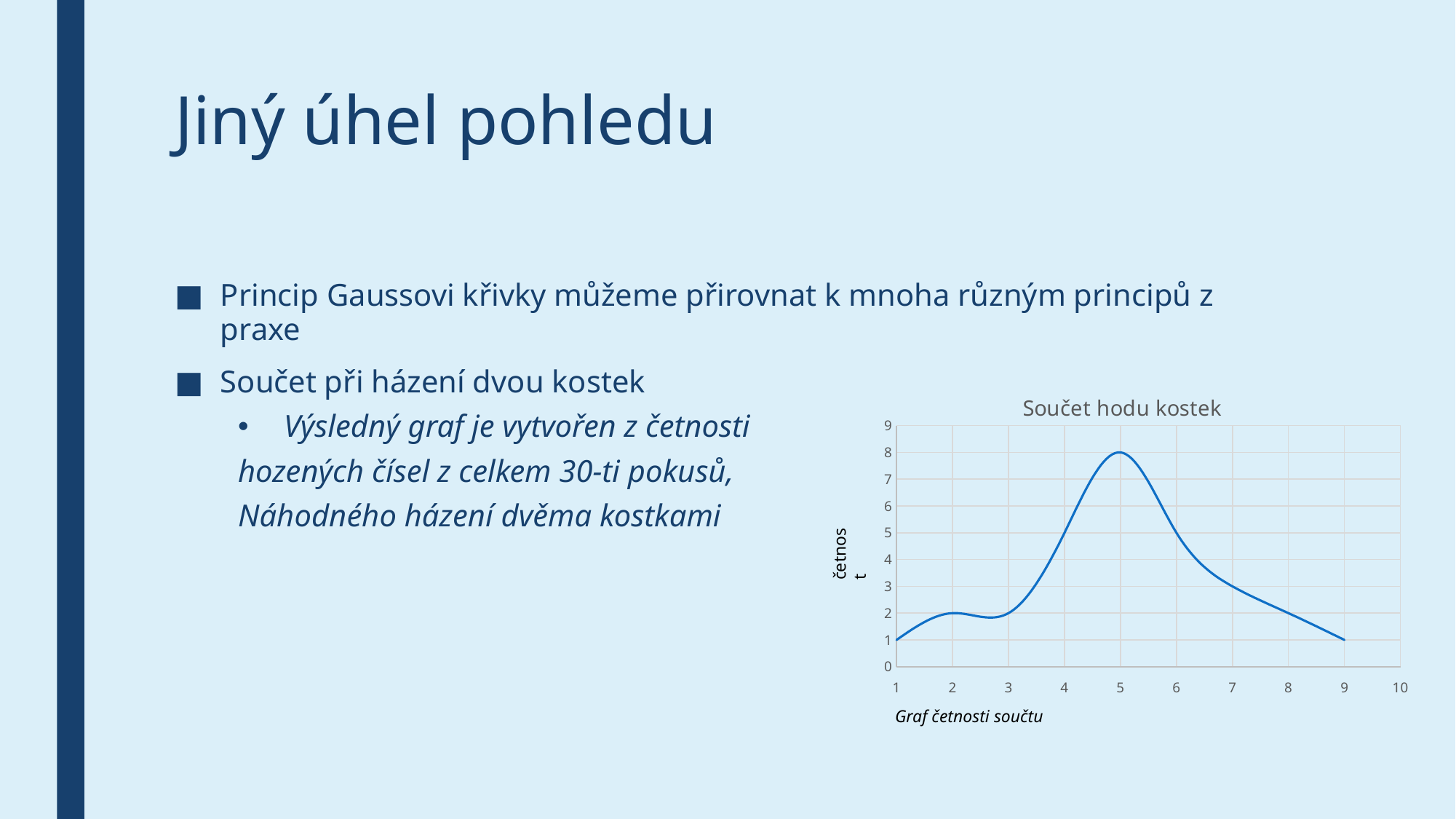
What kind of chart is shown on the slide? line chart What is the value of the line at x = 9? 1 Does the line rise or fall between x = 5 and x = 9? fall Is the value at x = 6 greater or less than 4? greater What is the value of the line at x = 1? 1 At which x value does the line reach its highest point? 5 What is the title of the chart? Součet hodu kostek Is the value at x = 4 greater or less than 3? greater Is the value at x = 7 greater or less than 5? less Which is larger, the value at x = 4 or the value at x = 8? x = 4 What is the value of the line at x = 5? 8 What is the label of the vertical axis of the chart? četnost